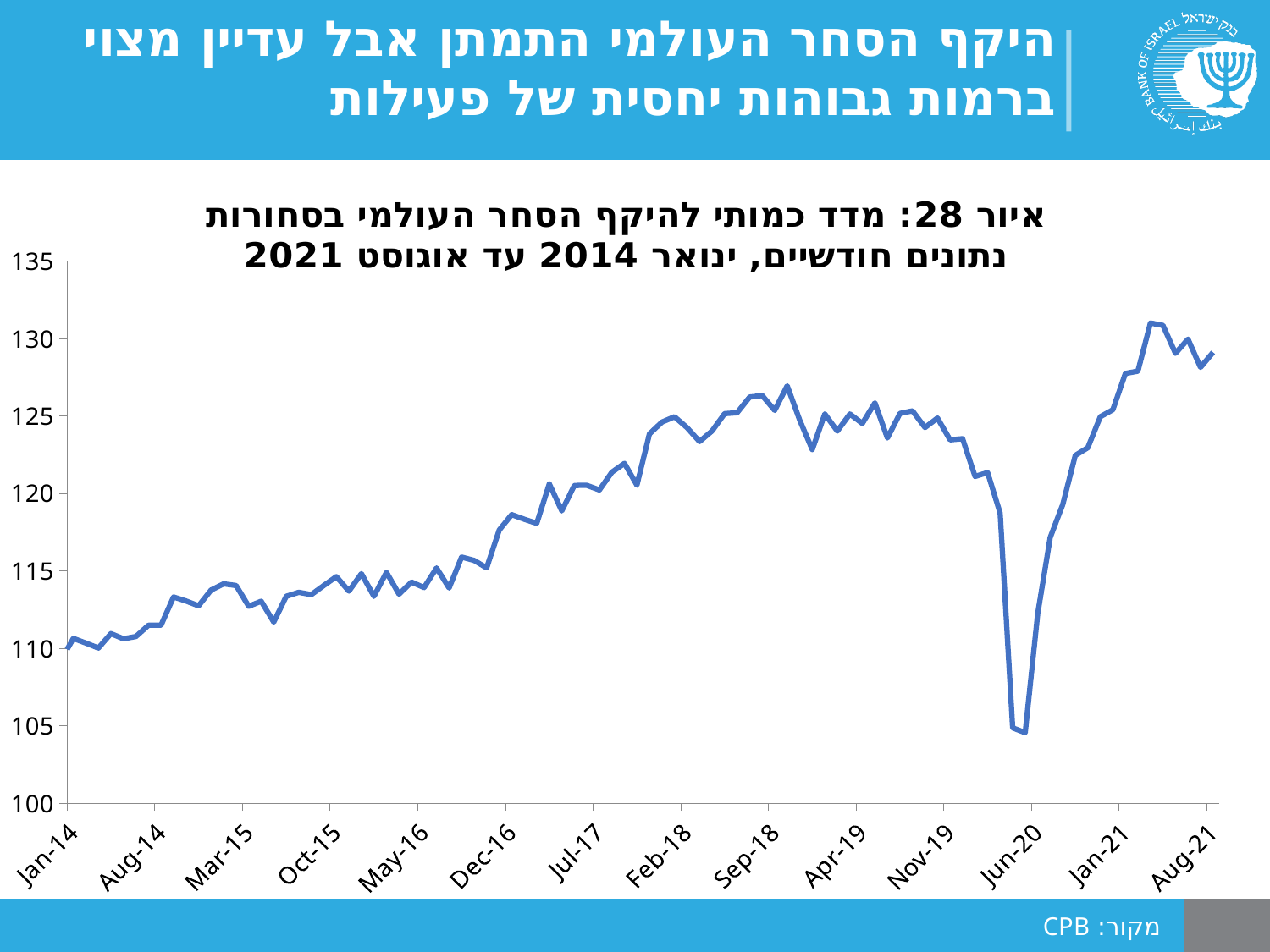
Is the value at Feb-18 greater or less than 120? greater Does the line generally rise or fall from Jan-14 to Aug-21? rise Which is larger, the value at Jan-14 or the value at Aug-21? Aug-21 Is the value at Jan-14 greater or less than 115? less Near which x-axis label does the line reach its lowest point? Jun-20 How many series does the chart plot? 1 What kind of chart is shown on the slide? line chart What source is cited at the bottom of the slide? CPB Is the value at Aug-21 greater or less than 125? greater